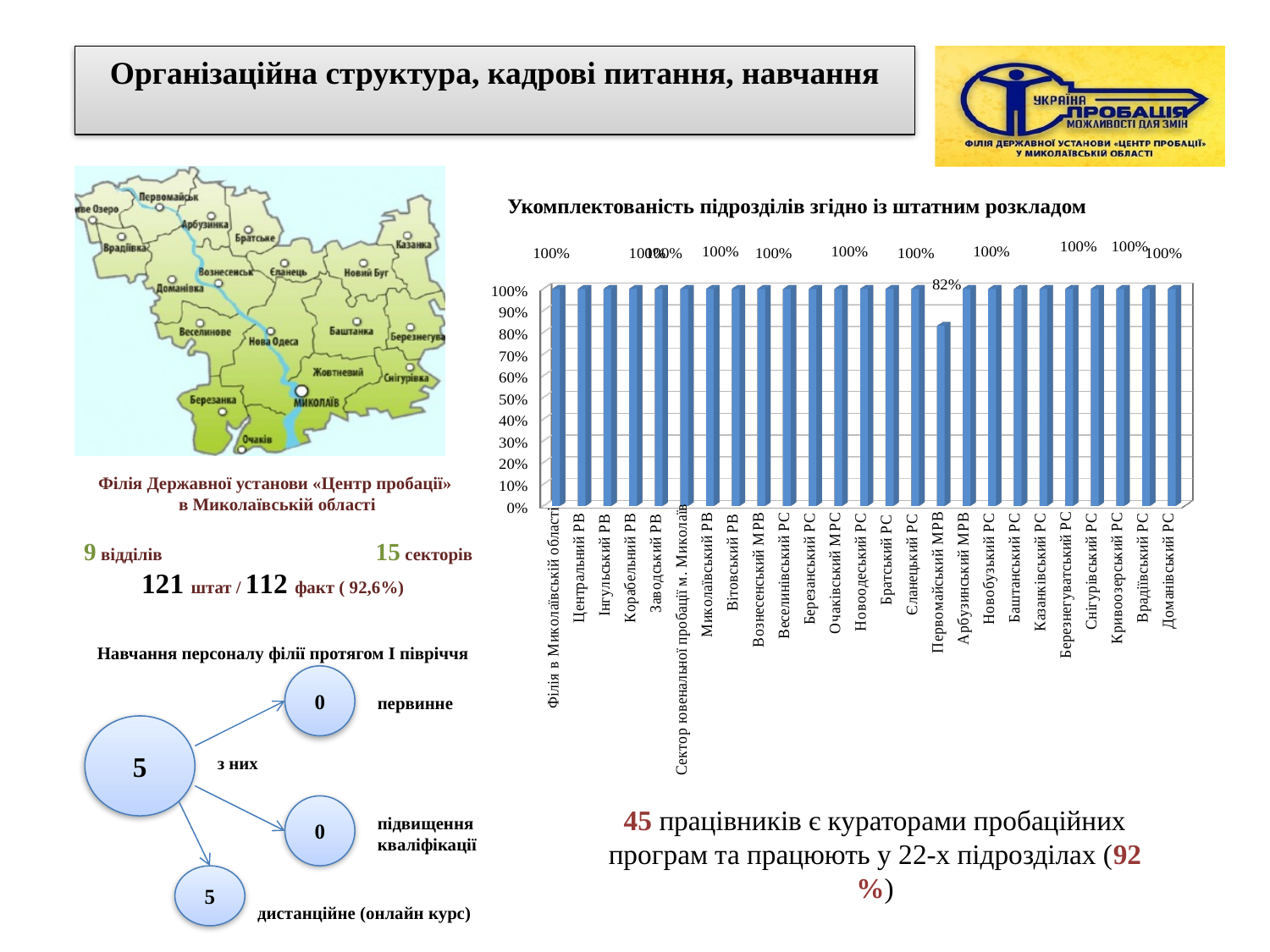
In the chart 'Укомплектованість підрозділів згідно із штатним розкладом', what is the value for Центральний РВ? 100% In the chart 'Укомплектованість підрозділів згідно із штатним розкладом', what is the value for Первомайський МРВ? 82% What is the title of the bar chart on the right side of the slide? Укомплектованість підрозділів згідно із штатним розкладом In the chart 'Укомплектованість підрозділів згідно із штатним розкладом', what is the value for Доманівський РС? 100% In the chart 'Укомплектованість підрозділів згідно із штатним розкладом', what is the difference between the value for Арбузинський МРВ and the value for Первомайський МРВ? 18% In the chart 'Укомплектованість підрозділів згідно із штатним розкладом', is the value for Первомайський МРВ greater or less than 90%? less In the chart 'Укомплектованість підрозділів згідно із штатним розкладом', which category has the lowest value? Первомайський МРВ In the chart 'Укомплектованість підрозділів згідно із штатним розкладом', is the value for Первомайський МРВ greater or less than 80%? greater How many categories (bars) are shown in the chart 'Укомплектованість підрозділів згідно із штатним розкладом'? 25 In the chart 'Укомплектованість підрозділів згідно із штатним розкладом', which is larger: the value for Братський РС or the value for Первомайський МРВ? Братський РС What kind of chart is used to show 'Укомплектованість підрозділів згідно із штатним розкладом'? bar chart What is the highest value shown on the vertical axis of the chart 'Укомплектованість підрозділів згідно із штатним розкладом'? 100%